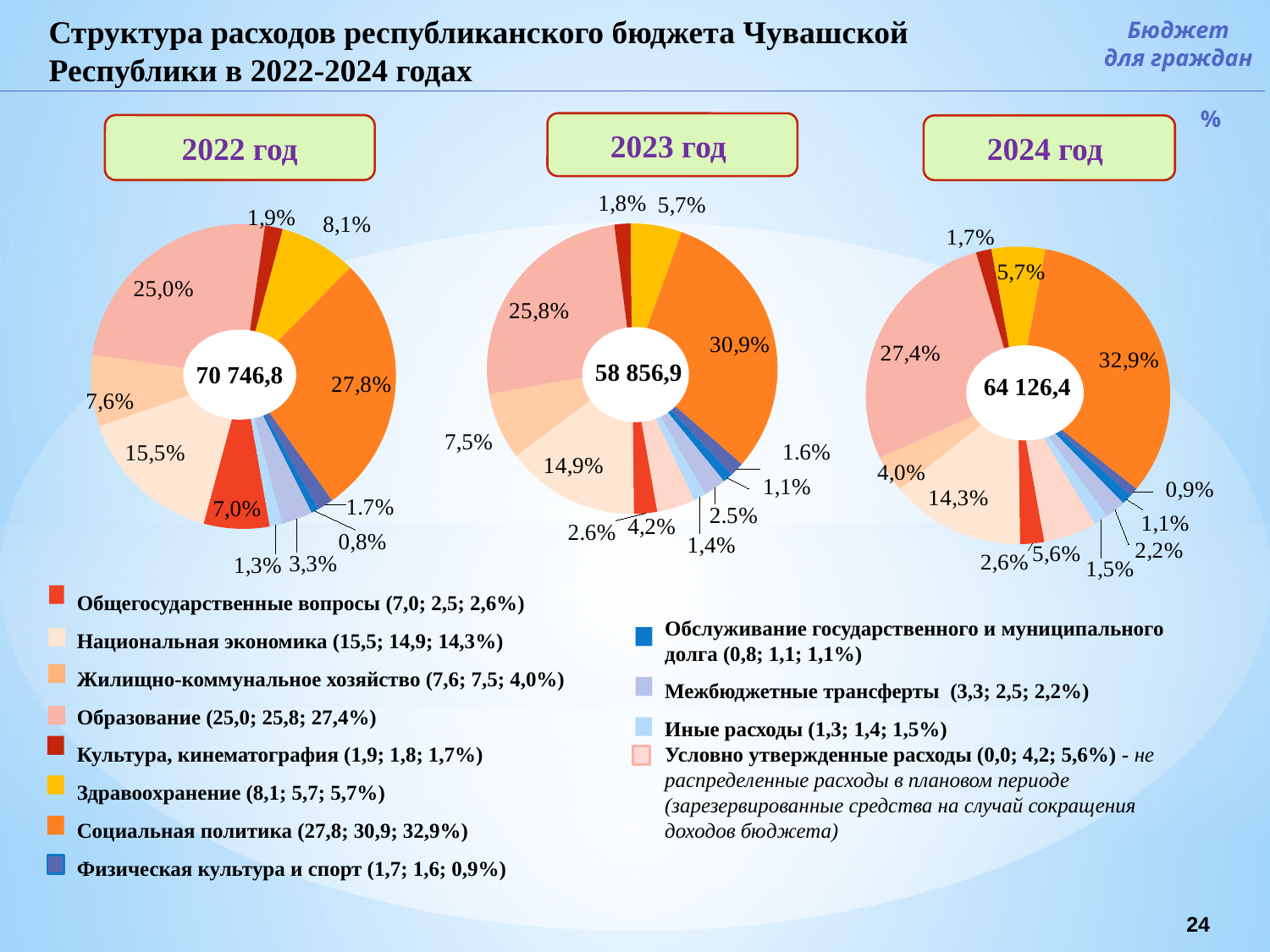
In the 2024 год chart, which category has the largest share? Социальная политика What total value is printed in the centre of the 2024 год chart? 64 126,4 In the 2023 год chart, what is the difference between the shares of Социальная политика and Образование? 5,1% In the 2022 год chart, what share is shown for Социальная политика? 27,8% In the 2024 год chart, what share is shown for Национальная экономика? 14,3% What type of charts are shown on the slide? Pie charts In the 2022 год chart, which is larger: the share of Здравоохранение or the share of Жилищно-коммунальное хозяйство? Здравоохранение How does the share of Социальная политика change from the 2022 год chart to the 2024 год chart? It rises (27,8% to 30,9% to 32,9%) How many categories does the legend list? 12 What total value is printed in the centre of the 2023 год chart? 58 856,9 In the 2023 год chart, what share is shown for Образование? 25,8%